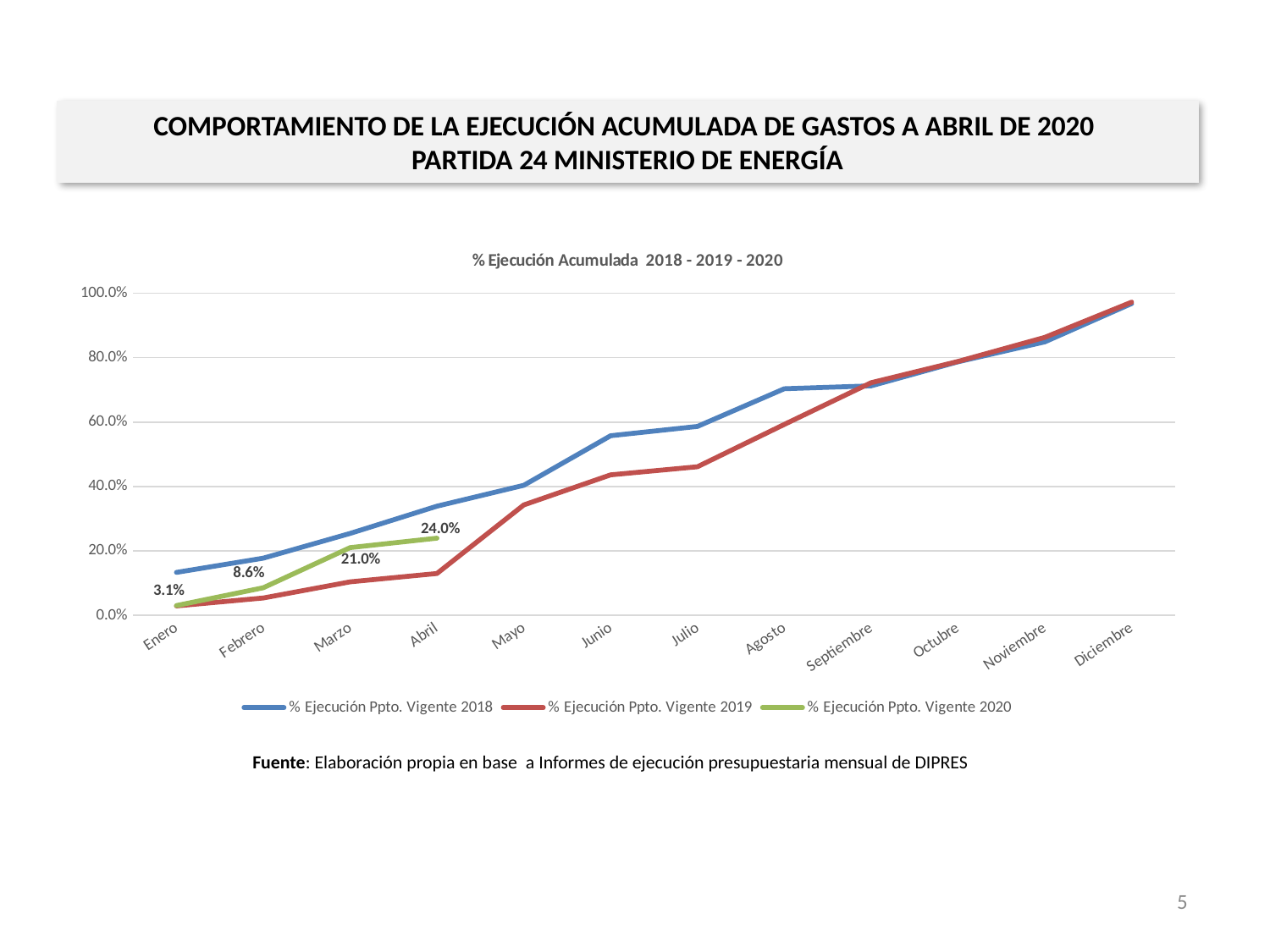
What is the difference between the 2020 values for Abril and Marzo? 3.0% What is the value of % Ejecución Ppto. Vigente 2020 in Marzo? 21.0% What is the value of % Ejecución Ppto. Vigente 2020 in Enero? 3.1% How many months are shown along the x axis? 12 What is the value of % Ejecución Ppto. Vigente 2020 in Abril? 24.0% What is the difference between the 2020 values for Febrero and Enero? 5.5% What kind of chart is shown on the slide? line chart Is the value for % Ejecución Ppto. Vigente 2019 in Abril greater or less than 20.0%? less Is the value for % Ejecución Ppto. Vigente 2018 in Agosto greater or less than 60.0%? greater In Mayo, which series has the higher value, 2018 or 2019? % Ejecución Ppto. Vigente 2018 Do the values of % Ejecución Ppto. Vigente 2019 rise or fall from Enero to Diciembre? rise How many series does the legend list? 3